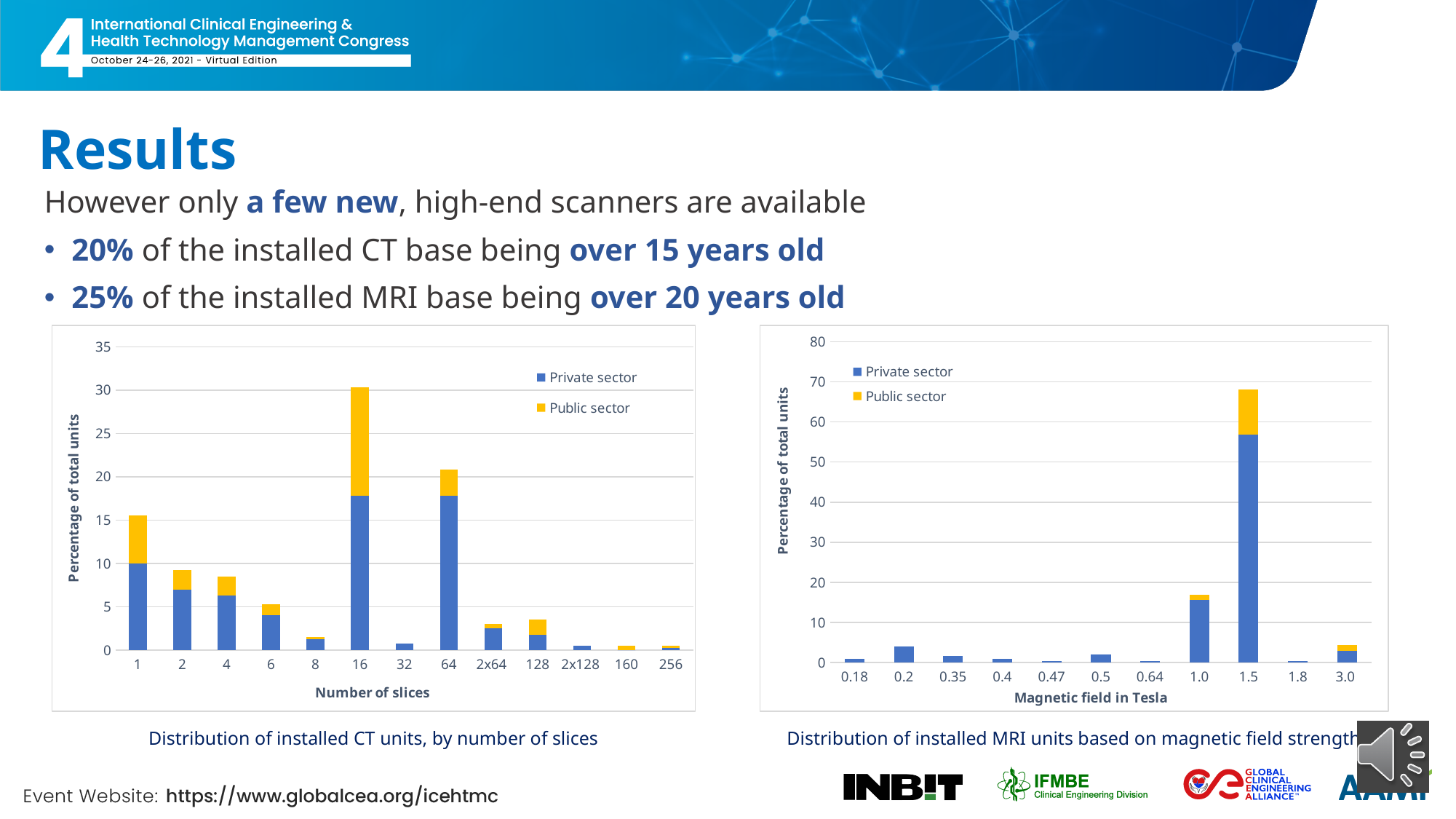
In the chart on the right (Distribution of installed MRI units based on magnetic field strength), which magnetic field strength has the highest total percentage of units? 1.5 In the chart on the right (MRI units by magnetic field strength), is the total value for 1.0 Tesla greater or less than 20? less In the chart on the right (MRI units by magnetic field strength), is the total value for 1.5 Tesla greater or less than 60? greater In the chart on the left (CT units by number of slices), is the total value for 16 slices greater or less than 25? greater In the chart on the left (CT units by number of slices), which has a larger total value, 64 slices or 128 slices? 64 slices In the chart on the right (MRI units by magnetic field strength), how many magnetic field categories are shown on the x axis? 11 In the chart on the left (CT units by number of slices), how many slice categories are shown on the x axis? 13 In the chart on the right (MRI units by magnetic field strength), which has a larger total value, 1.0 Tesla or 3.0 Tesla? 1.0 Tesla What kind of chart is the chart on the right (MRI units by magnetic field strength)? Stacked bar chart In the chart on the left (CT units by number of slices), how many series does the legend list? 2 In the chart on the left (Distribution of installed CT units, by number of slices), which number of slices has the highest total percentage of units? 16